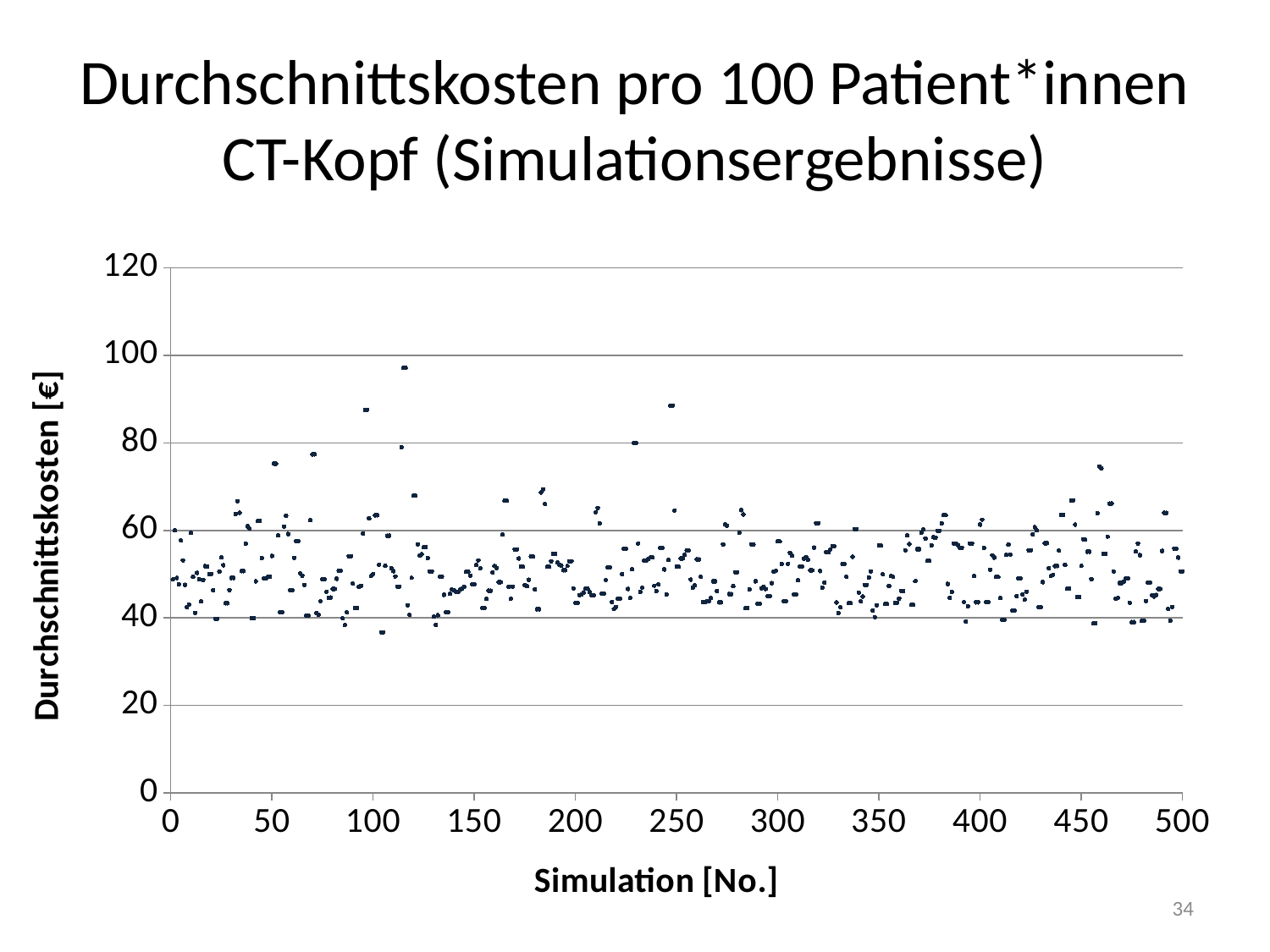
What kind of chart is shown on the slide? scatter plot Is the value for simulation number 115 (the highest point) greater or less than 90? greater Is the highest plotted value in the chart greater or less than 80? greater Is the value for simulation number 250 (the isolated high point near 250) greater or less than 80? greater What is the title of the chart's horizontal axis? Simulation [No.] Do the plotted values show a clear rising or falling trend along the x axis, or do they stay roughly level? roughly level What is the title of the chart's vertical axis? Durchschnittskosten [€]